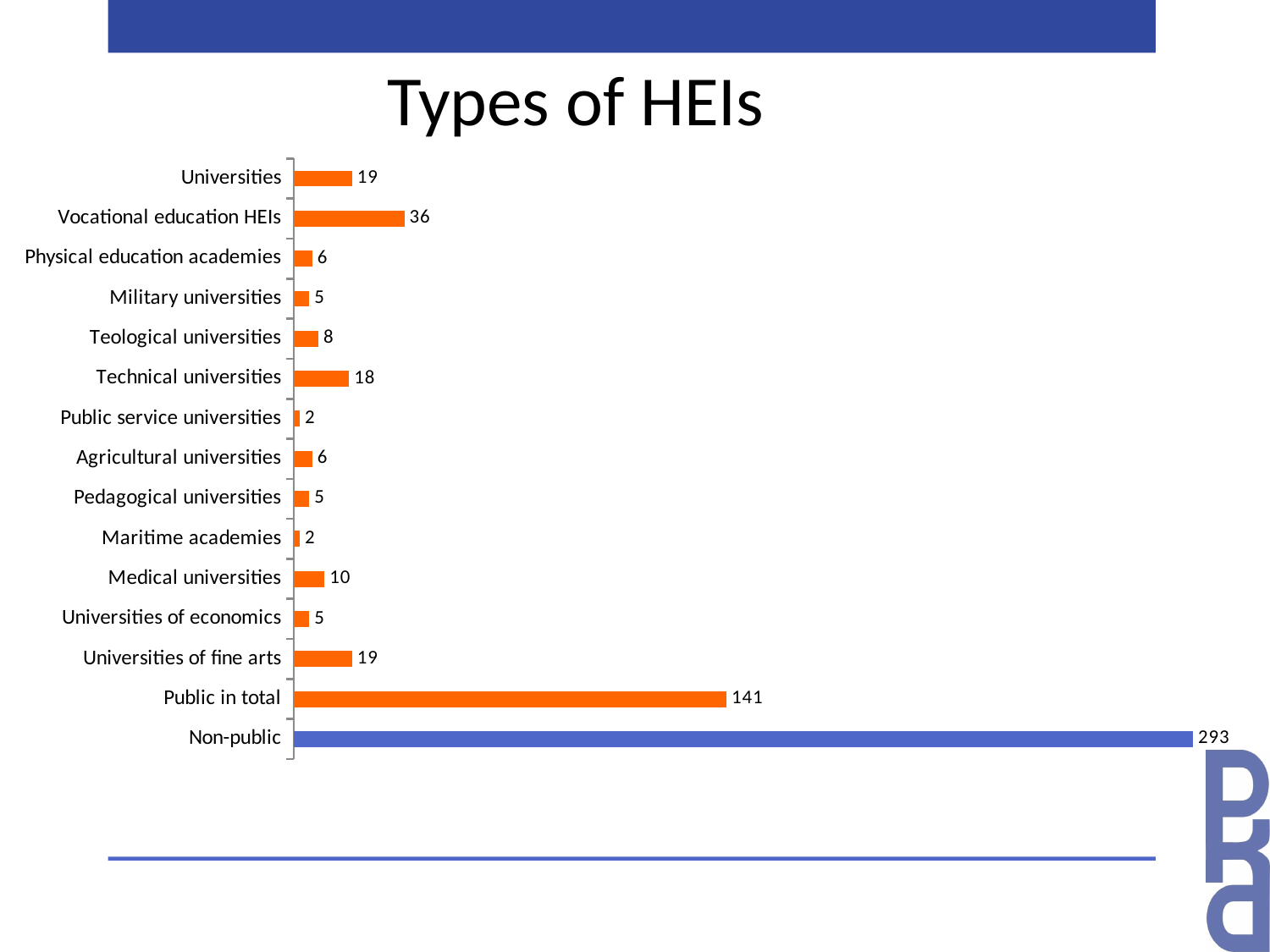
What is the value for Public in total? 141 What colour is the bar for Non-public? Blue Which is larger, Universities or Teological universities? Universities What is the value for Medical universities? 10 What is the title of the slide? Types of HEIs What is the difference between Non-public and Public in total? 152 What kind of chart is shown on the slide? Bar chart How many categories are shown on the chart? 15 What is the value for Non-public? 293 What is the difference between Vocational education HEIs and Technical universities? 18 What is the value for Vocational education HEIs? 36 Which category has the highest value? Non-public